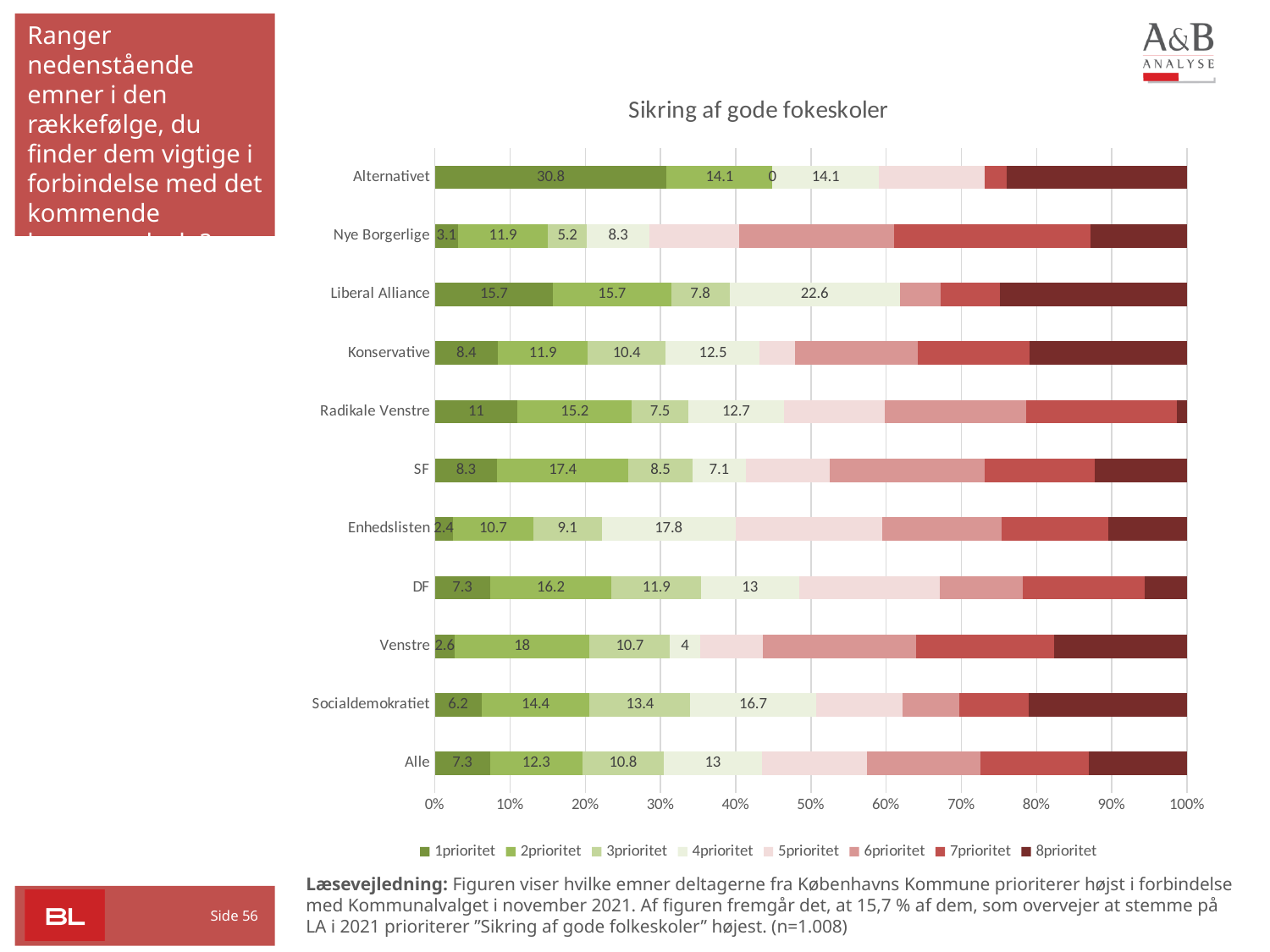
What is the 1prioritet value for Alternativet? 30.8 What is the 4prioritet value for Liberal Alliance? 22.6 What is the difference between the 4prioritet value for Liberal Alliance and the 4prioritet value for Alle? 9.6 How many series does the legend list? 8 What is the 3prioritet value for Socialdemokratiet? 13.4 How many categories are shown on the y axis? 11 Which is larger: the 2prioritet value for Venstre or the 2prioritet value for Alle? Venstre Which category has the lowest 1prioritet value? Enhedslisten Which category has the highest 1prioritet value? Alternativet What is the 2prioritet value for SF? 17.4 What kind of chart is shown on the slide? Stacked bar chart What is the title of the chart? Sikring af gode fokeskoler